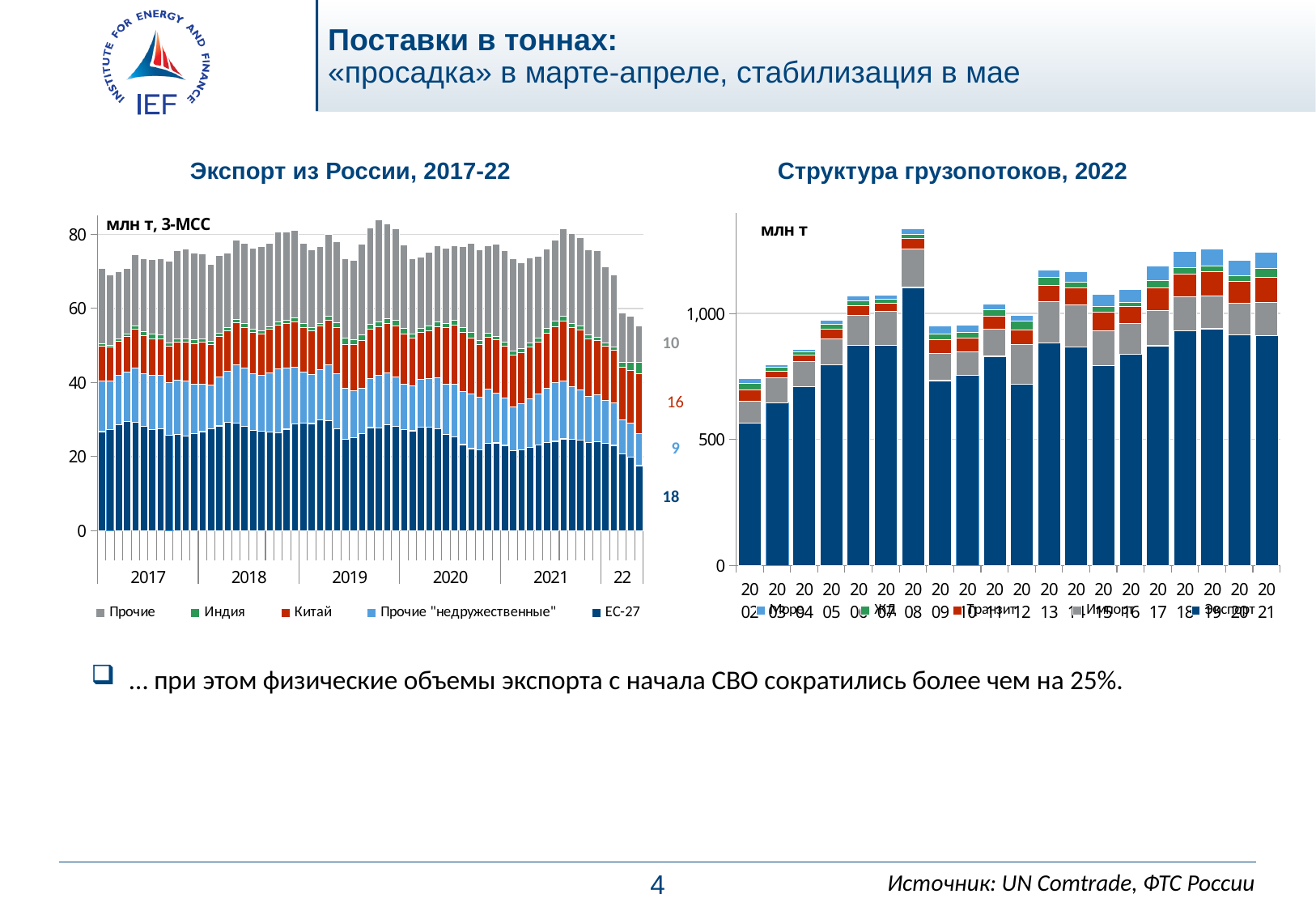
In the left chart 'Экспорт из России, 2017-22', what value is labelled for ЕС-27 at the end of the series? 18 In the left chart 'Экспорт из России, 2017-22', what is the difference between the labelled end values for Китай (16) and Прочие "недружественные" (9)? 7 In the right chart 'Структура грузопотоков, 2022', which year has the lowest total bar? 2002 In the right chart 'Структура грузопотоков, 2022', is the total for 2002 greater or less than 1,000? less How many series does the legend of the right chart 'Структура грузопотоков, 2022' list? 5 In the left chart 'Экспорт из России, 2017-22', what value is labelled for Китай at the end of the series? 16 How many years are shown on the x axis of the right chart 'Структура грузопотоков, 2022'? 20 What kind of chart is the left chart, 'Экспорт из России, 2017-22'? Stacked bar chart In the right chart 'Структура грузопотоков, 2022', is the total for 2008 greater or less than 1,000? greater How many series does the legend of the left chart 'Экспорт из России, 2017-22' list? 5 In the left chart 'Экспорт из России, 2017-22', do the total bars rise or fall from 2021 into 2022? fall In the right chart 'Структура грузопотоков, 2022', which year has the highest total bar? 2008